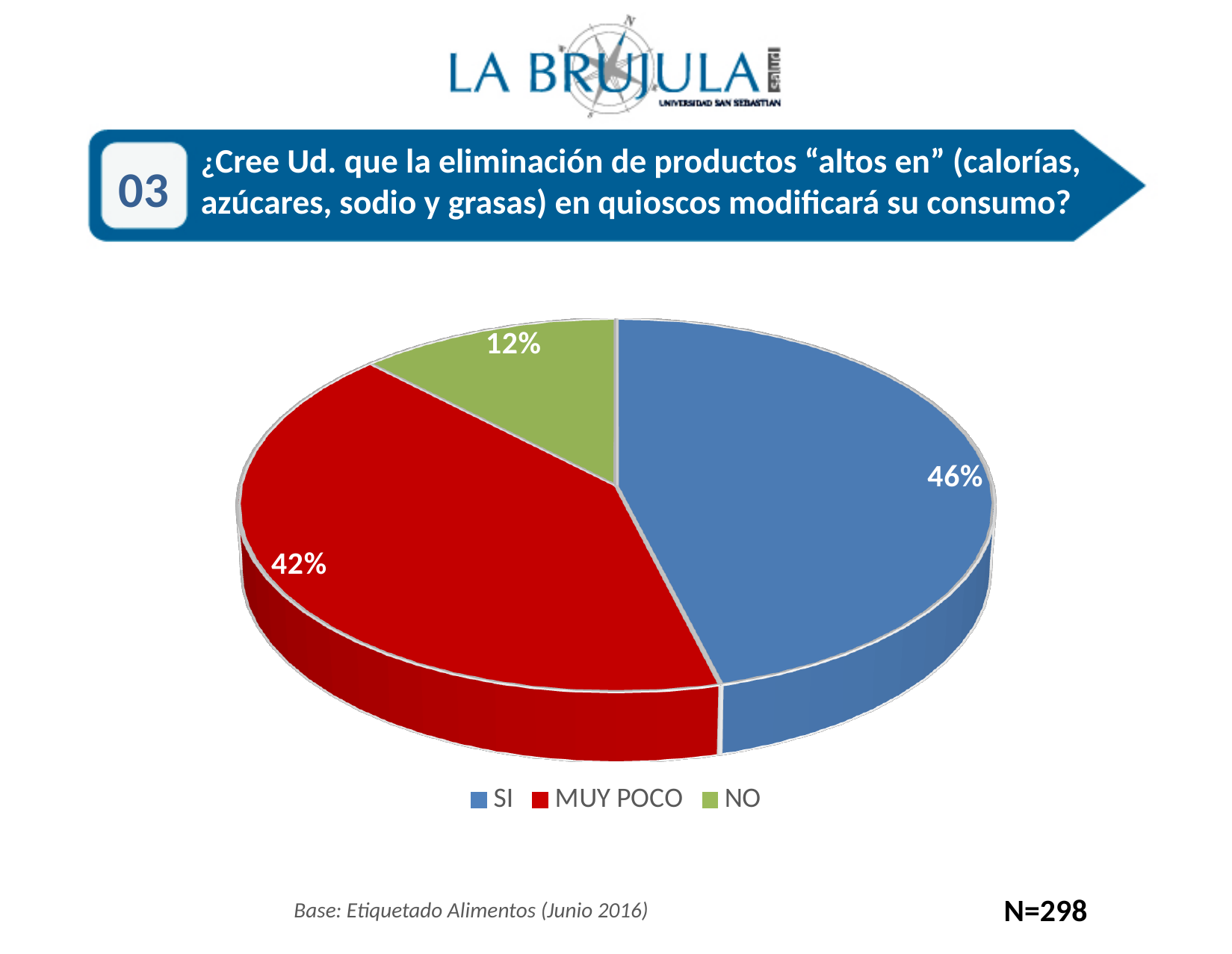
What colour represents MUY POCO in the pie chart? Red How many categories does the pie chart show? 3 What percentage of respondents answered MUY POCO? 42% Which response has the smallest share of the pie? NO What kind of chart is shown on the slide? Pie chart What is the sample size (N) shown on the slide? N=298 What is the difference in percentage points between MUY POCO and NO? 30 What percentage of respondents answered SI? 46% Which response has the largest share of the pie? SI Which is larger, the share for SI or the share for NO? SI What is the difference in percentage points between SI and MUY POCO? 4 What percentage of respondents answered NO? 12%